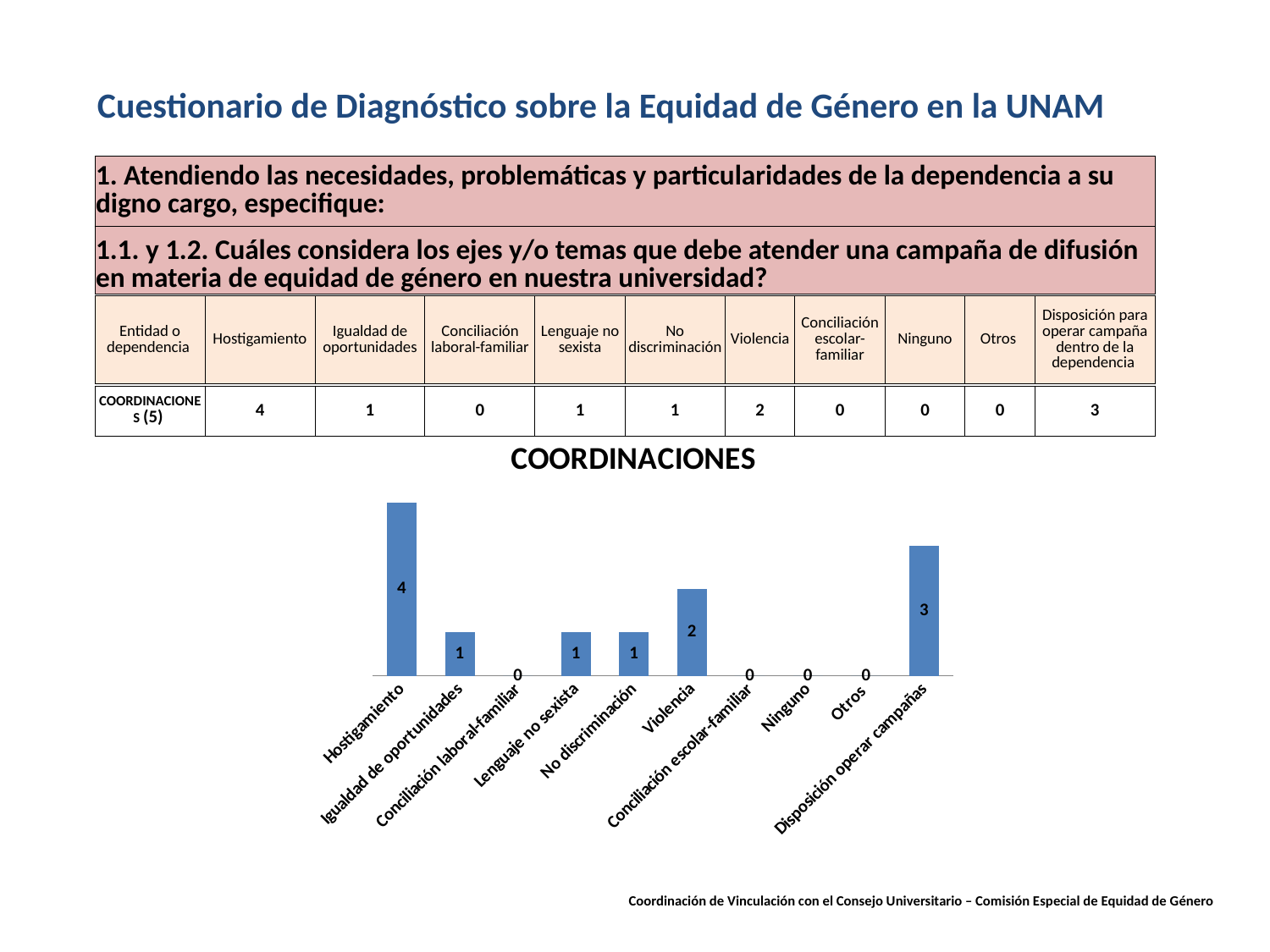
How many categories are shown on the x axis of the COORDINACIONES chart? 10 What is the difference between the values for Hostigamiento and Disposición operar campañas in the COORDINACIONES chart? 1 What kind of chart is the COORDINACIONES chart? bar chart What is the value for Conciliación laboral-familiar in the COORDINACIONES chart? 0 What is the difference between the values for Violencia and No discriminación in the COORDINACIONES chart? 1 How many categories in the COORDINACIONES chart have a value of 0? 4 What is the value for Hostigamiento in the COORDINACIONES chart? 4 What is the value for Violencia in the COORDINACIONES chart? 2 What is the title of the chart on the slide? COORDINACIONES Which is larger in the COORDINACIONES chart, Violencia or Igualdad de oportunidades? Violencia Which category has the highest value in the COORDINACIONES chart? Hostigamiento What is the value for Disposición operar campañas in the COORDINACIONES chart? 3